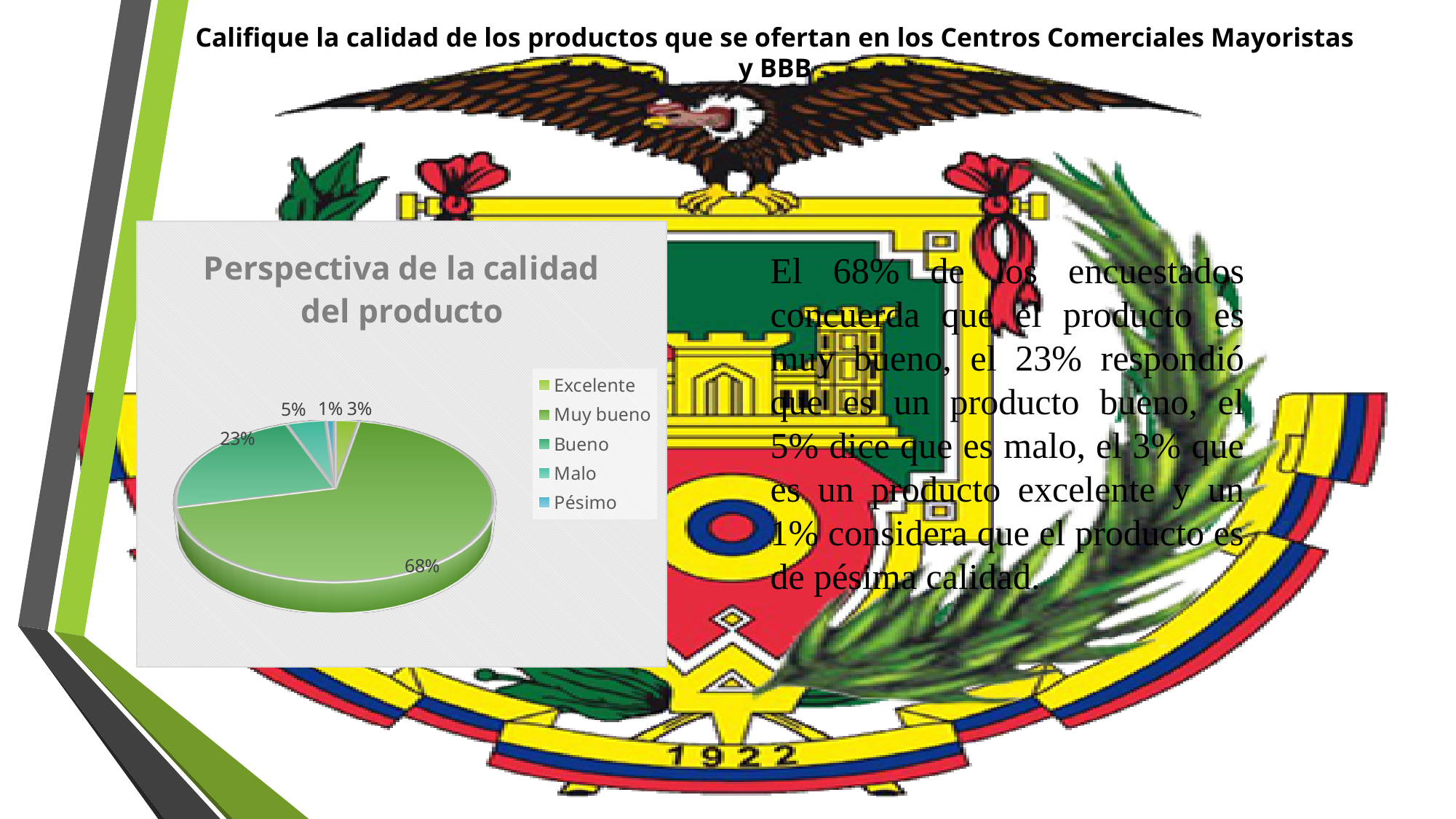
What share of the pie chart is labelled for Muy bueno? 68% How many categories does the legend of the pie chart list? 5 What is the difference in percentage points between the Muy bueno slice and the Bueno slice? 45 Which category has the largest slice in the pie chart? Muy bueno What share of the pie chart is labelled for Excelente? 3% Which category has the smallest slice in the pie chart? Pésimo What share of the pie chart is labelled for Malo? 5% What kind of chart is shown on the slide? Pie chart What share of the pie chart is labelled for Bueno? 23% What is the title of the chart? Perspectiva de la calidad del producto What share of the pie chart is labelled for Pésimo? 1% Which slice is larger, Malo or Excelente? Malo